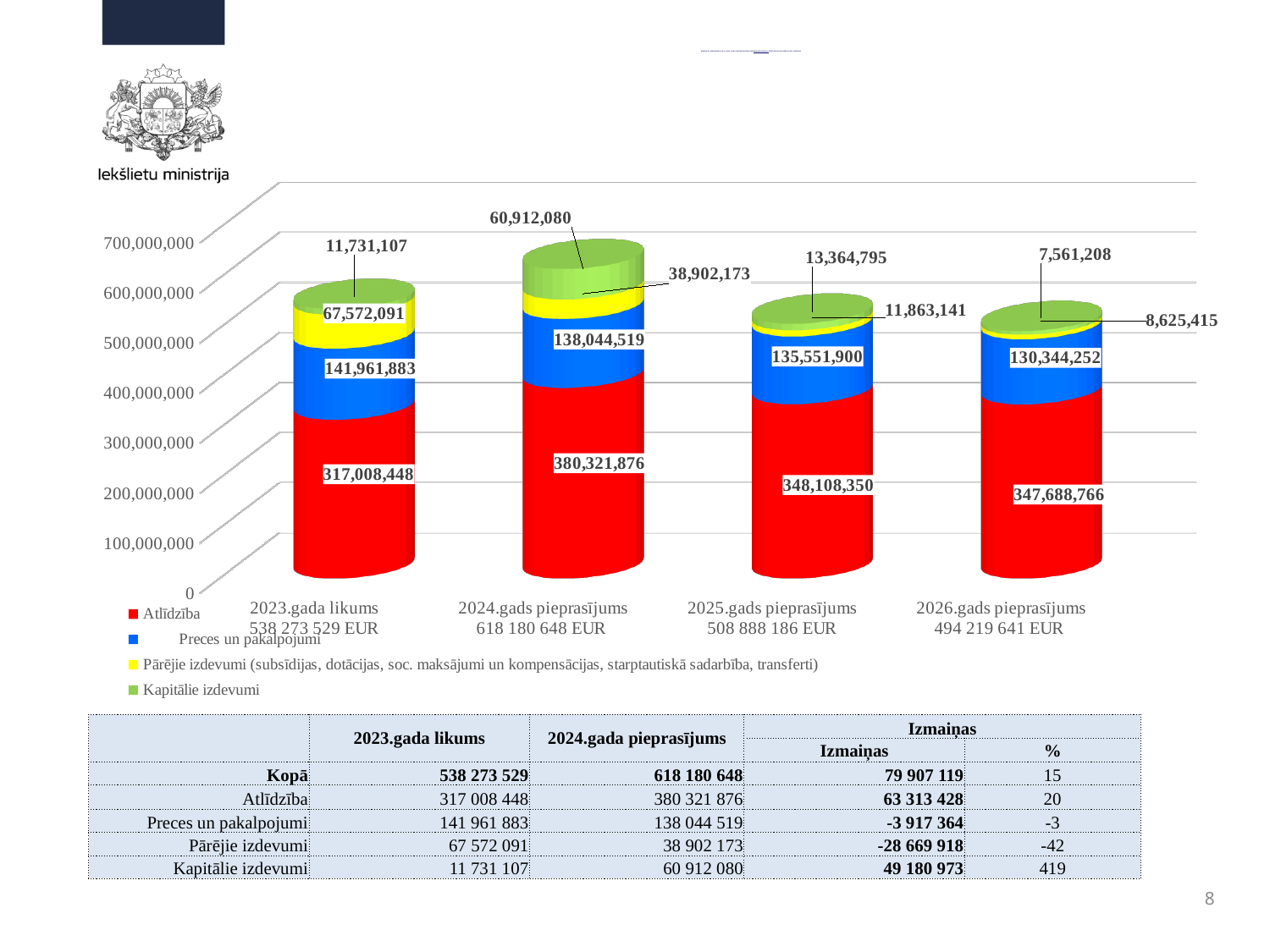
What is the value of Preces un pakalpojumi for 2026.gads pieprasījums? 130,344,252 Which year has the highest Kapitālie izdevumi value? 2024.gads pieprasījums What kind of chart is shown? Stacked bar chart What is the value of Pārējie izdevumi for 2025.gads pieprasījums? 11,863,141 Which year has the lowest Pārējie izdevumi value? 2026.gads pieprasījums How many series does the legend list? 4 What is the total of the stacked bar for 2025.gads pieprasījums? 508 888 186 EUR Which is larger: Preces un pakalpojumi for 2023.gada likums or for 2025.gads pieprasījums? 2023.gada likums What is the value of Kapitālie izdevumi for 2023.gada likums? 11,731,107 How many years (categories) are shown on the x axis? 4 What is the difference between the Atlīdzība values for 2024.gads pieprasījums and 2023.gada likums? 63,313,428 What is the value of Atlīdzība for 2024.gads pieprasījums? 380,321,876